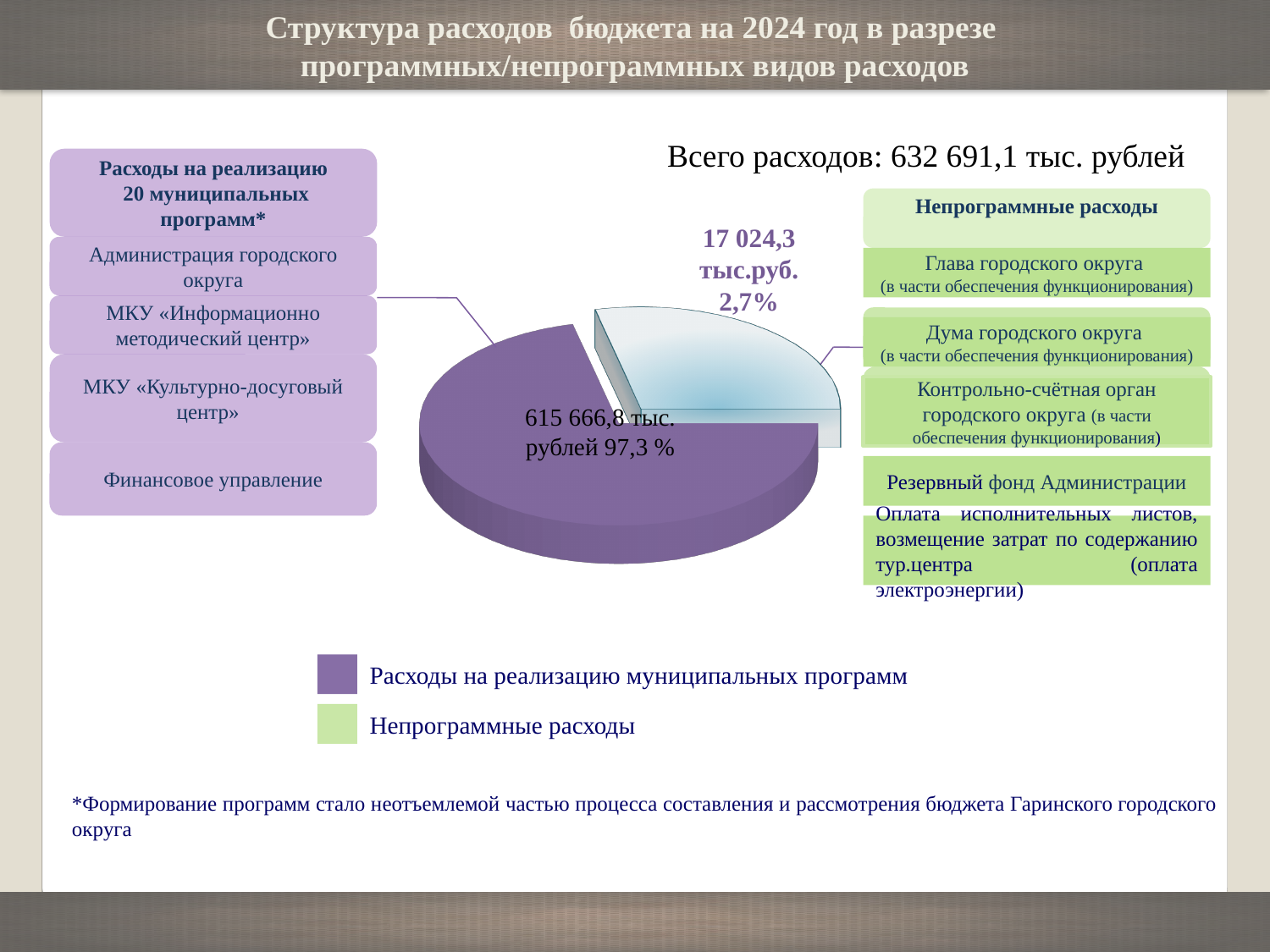
Which slice of the pie chart is the smallest? Непрограммные расходы How many slices does the pie chart have? 2 What is the value shown for non-program expenses (Непрограммные расходы)? 17 024,3 тыс.руб. What is the value shown for expenses on implementing municipal programs (Расходы на реализацию муниципальных программ)? 615 666,8 тыс. рублей What share of the pie do non-program expenses (Непрограммные расходы) represent? 2,7% How many entries does the legend list? 2 Which slice of the pie chart is the largest? Расходы на реализацию муниципальных программ What is the total of all expenses shown on the slide? 632 691,1 тыс. рублей What colour is the slice for non-program expenses (Непрограммные расходы)? light blue What share of the pie do expenses on municipal programs (Расходы на реализацию муниципальных программ) represent? 97,3 % Which is larger: program expenses or non-program expenses? Расходы на реализацию муниципальных программ What kind of chart is shown on the slide? pie chart